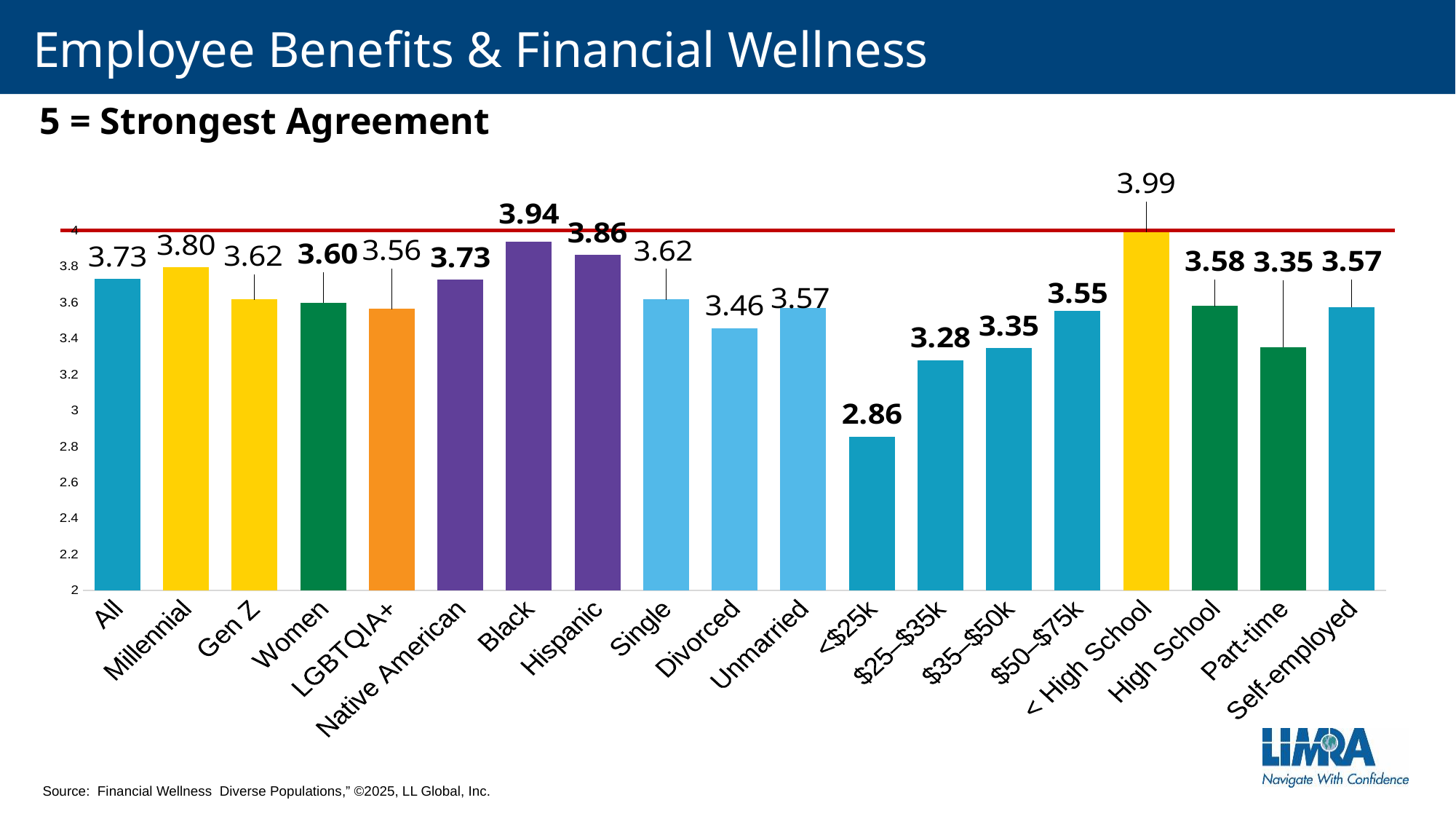
What kind of chart is shown on the slide? bar chart What is the difference between the values for < High School and <$25k? 1.13 Which is larger, the value for Women or the value for Divorced? Women Which category has the lowest value? <$25k How many categories are shown on the chart? 19 What is the value for Millennial? 3.80 What is the value for Black? 3.94 What is the value for Divorced? 3.46 What is the difference between the values for Black and Hispanic? 0.08 Is the value for $25–$35k greater or less than 3.4? less Which category has the highest value? < High School What is the value for Part-time? 3.35